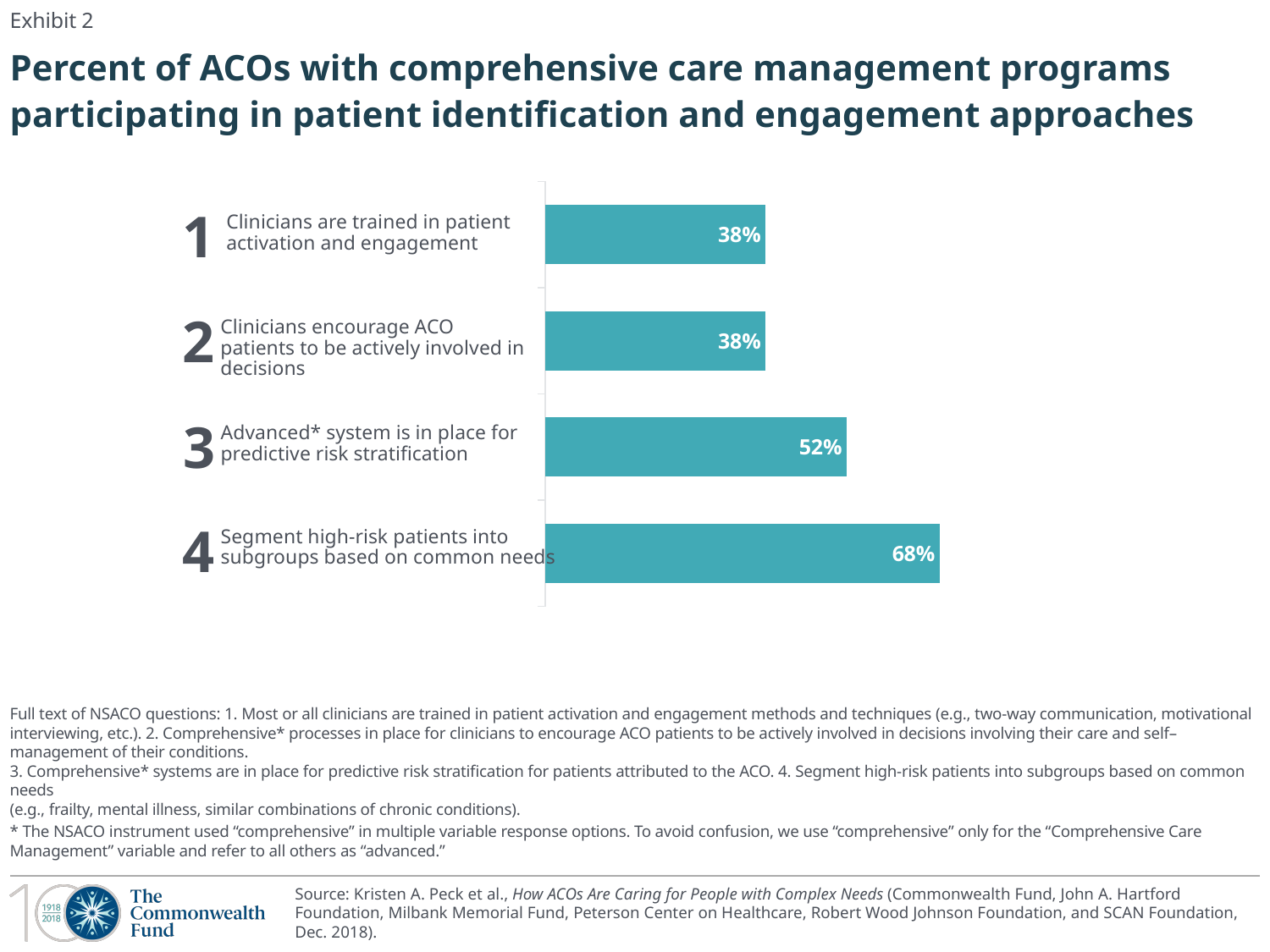
What percent of ACOs report that clinicians are trained in patient activation and engagement? 38% What exhibit number is shown on the slide? Exhibit 2 What percent of ACOs segment high-risk patients into subgroups based on common needs? 68% Which is larger: the value for advanced predictive risk stratification or the value for clinicians encouraging patient involvement in decisions? Advanced predictive risk stratification What type of chart is shown on the slide? Bar chart What is the difference between the value for segmenting high-risk patients into subgroups and the value for clinicians trained in patient activation and engagement? 30 percentage points How many approaches (bars) are shown in the chart? 4 What is the value for 'Advanced* system is in place for predictive risk stratification'? 52% Which approach has the highest percentage of ACOs participating? Segment high-risk patients into subgroups based on common needs What is the difference in percentage points between segmenting high-risk patients into subgroups and having an advanced system for predictive risk stratification? 16 percentage points What is the value for 'Clinicians encourage ACO patients to be actively involved in decisions'? 38% Which two approaches have the same percentage value? Clinicians are trained in patient activation and engagement; Clinicians encourage ACO patients to be actively involved in decisions